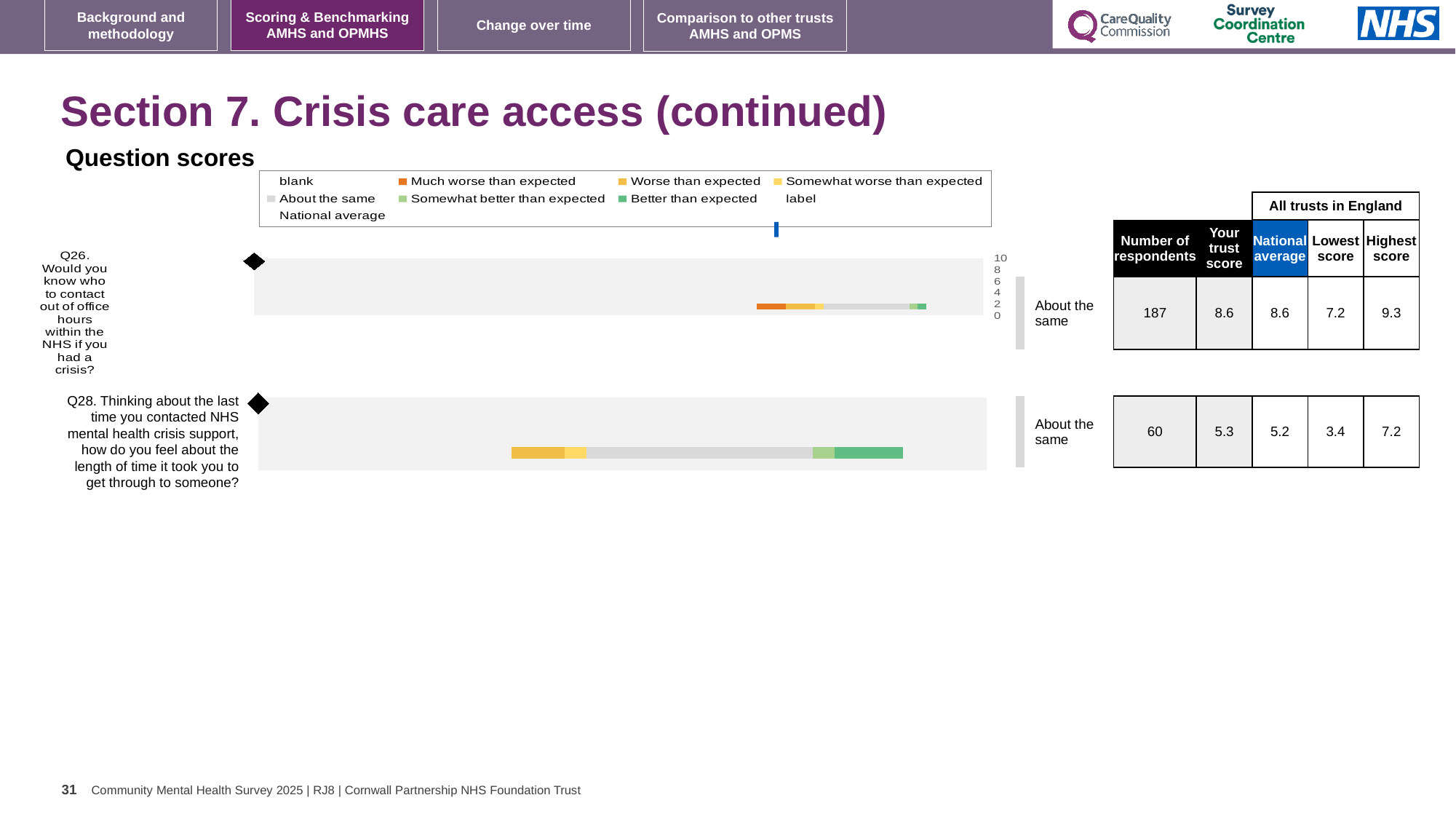
What is the lowest score among all trusts in England for Q28? 3.4 How many questions are plotted in the question scores chart? 2 What is the number of respondents for Q26 (Would you know who to contact out of office hours within the NHS if you had a crisis?)? 187 What is the highest score among all trusts in England for Q26? 9.3 What rating label is shown next to the Q28 bar? About the same What is the difference between the highest and lowest scores for Q28? 3.8 What kind of chart is used to show the question scores on this slide? bar chart Which question has the higher trust score, Q26 or Q28? Q26 What is the national average for Q28 (how do you feel about the length of time it took you to get through to someone)? 5.2 What is the difference between the highest and lowest scores for Q26? 2.1 What is the trust score for Q26 (Would you know who to contact out of office hours)? 8.6 Which is larger for Q28: the trust score or the national average? the trust score